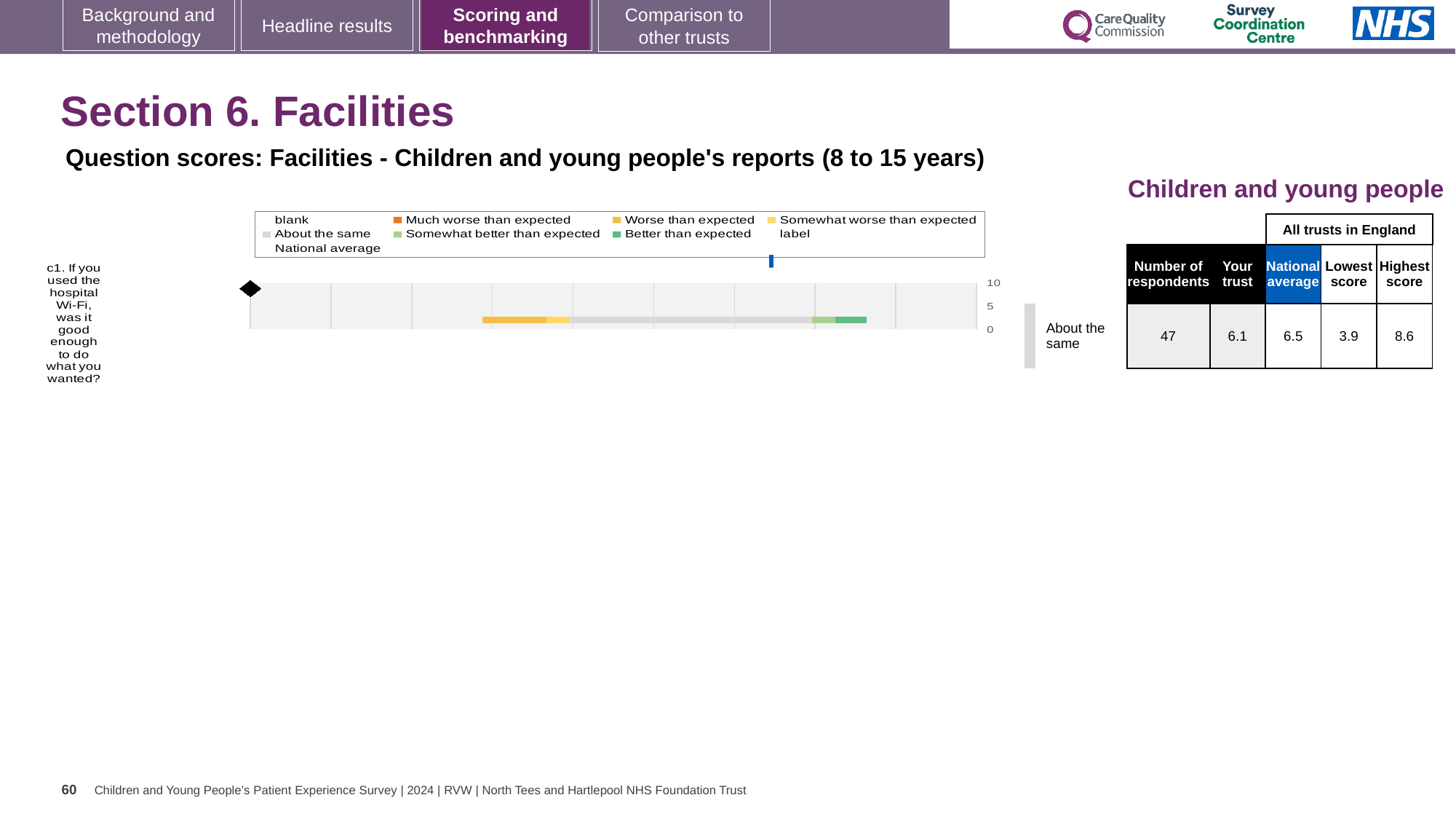
In the table beside the chart, what is the lowest score among all trusts in England for question c1? 3.9 What rating category is shown next to the chart for question c1? About the same What kind of chart is shown on the slide? bar chart For question c1, which is larger: the 'Your trust' score or the national average? National average In the table beside the chart, what is the 'Your trust' score for question c1? 6.1 What is the highest value shown on the chart's axis? 10 How many survey questions are plotted in the chart? 1 In the table beside the chart, how many respondents answered question c1? 47 In the table beside the chart, what is the highest score among all trusts in England for question c1? 8.6 For question c1, what is the difference between the highest score and the lowest score among all trusts in England? 4.7 Which survey question is plotted in the chart? c1. If you used the hospital Wi-Fi, was it good enough to do what you wanted? In the table beside the chart, what is the national average score for question c1? 6.5